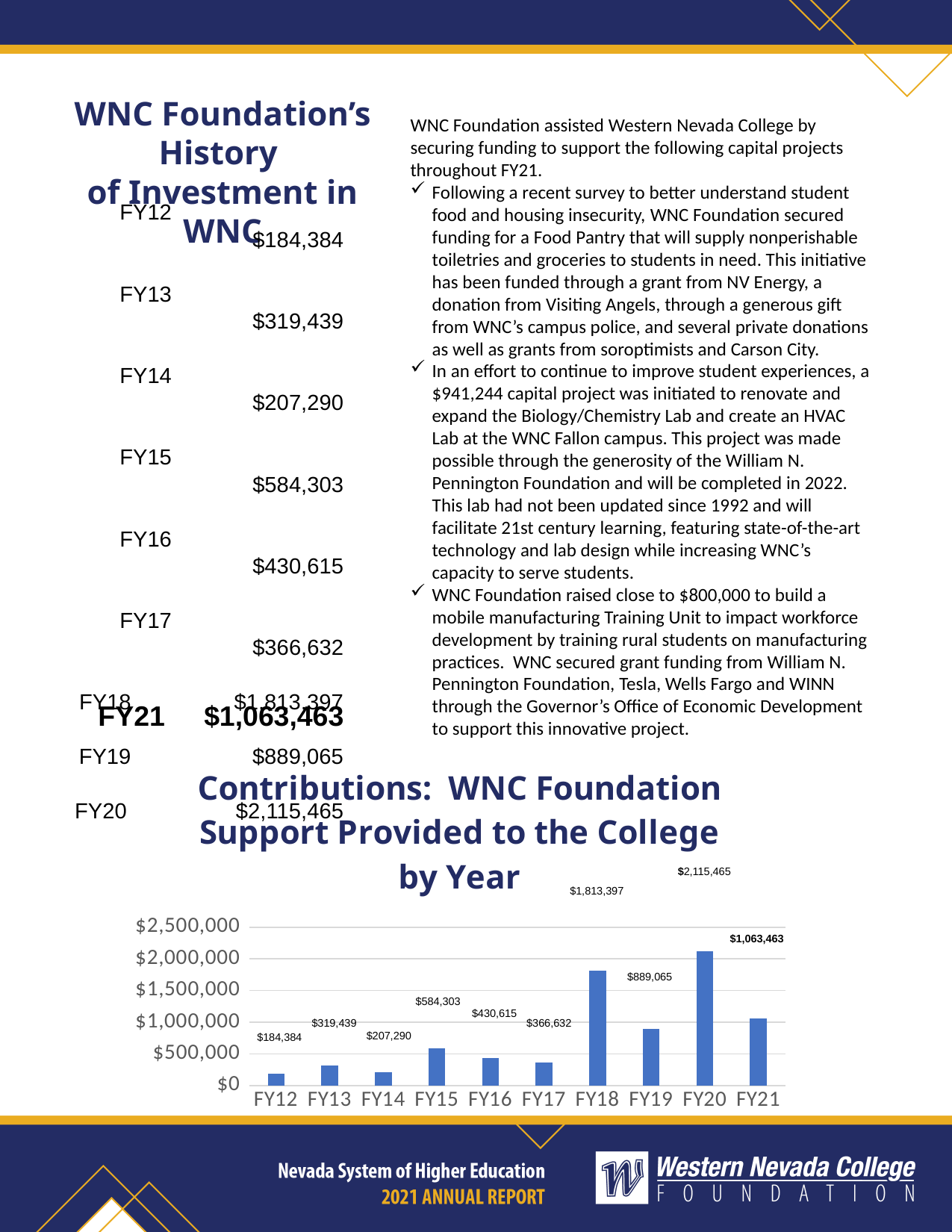
What is the title of the chart? Contributions: WNC Foundation Support Provided to the College by Year What is the value for FY21? $1,063,463 Do the values rise or fall from FY16 to FY17? fall Which fiscal year has the highest value? FY20 Which fiscal year has the lowest value? FY12 What is the value for FY20? $2,115,465 Which is larger, the value for FY19 or the value for FY21? FY21 What is the value for FY15? $584,303 Is the value for FY18 greater or less than $1,500,000? greater What is the difference between the values for FY20 and FY18? $302,068 How many fiscal years are plotted on the chart? 10 What type of chart is shown on the slide? Bar chart